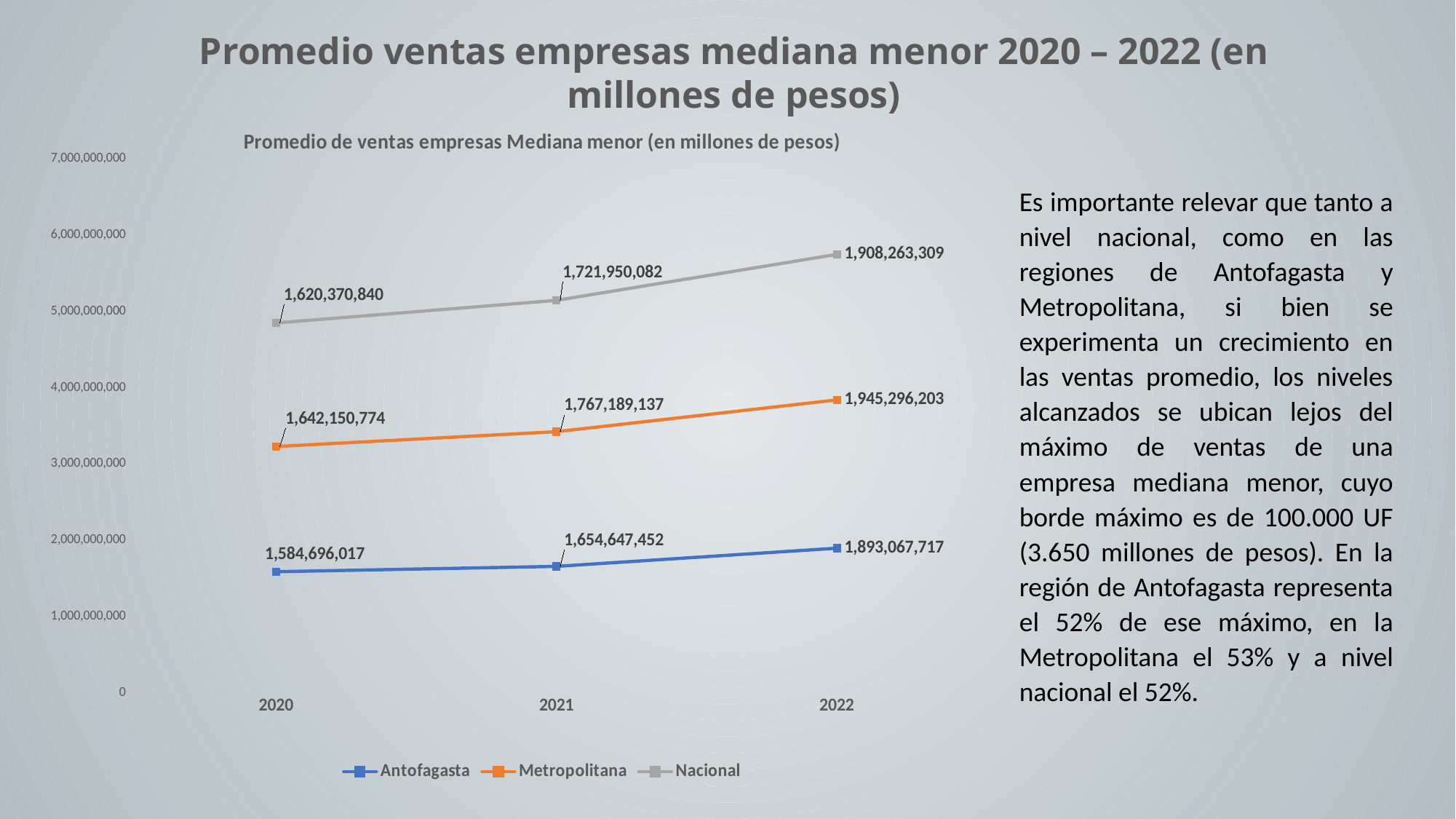
What is the value for Metropolitana in 2022? 1,945,296,203 Do the values for Antofagasta rise or fall from 2020 to 2022? Rise What is the difference between the Metropolitana values for 2022 and 2020? 303,145,429 How many years are shown on the x axis? 3 What kind of chart is shown on the slide? Line chart Which is larger in 2021, the value for Metropolitana or the value for Nacional? Metropolitana What is the value for Nacional in 2021? 1,721,950,082 How many series does the legend list? 3 What is the value for Antofagasta in 2022? 1,893,067,717 Which year has the lowest value for the Metropolitana series? 2020 What is the value for Antofagasta in 2020? 1,584,696,017 Which year has the highest value for the Nacional series? 2022